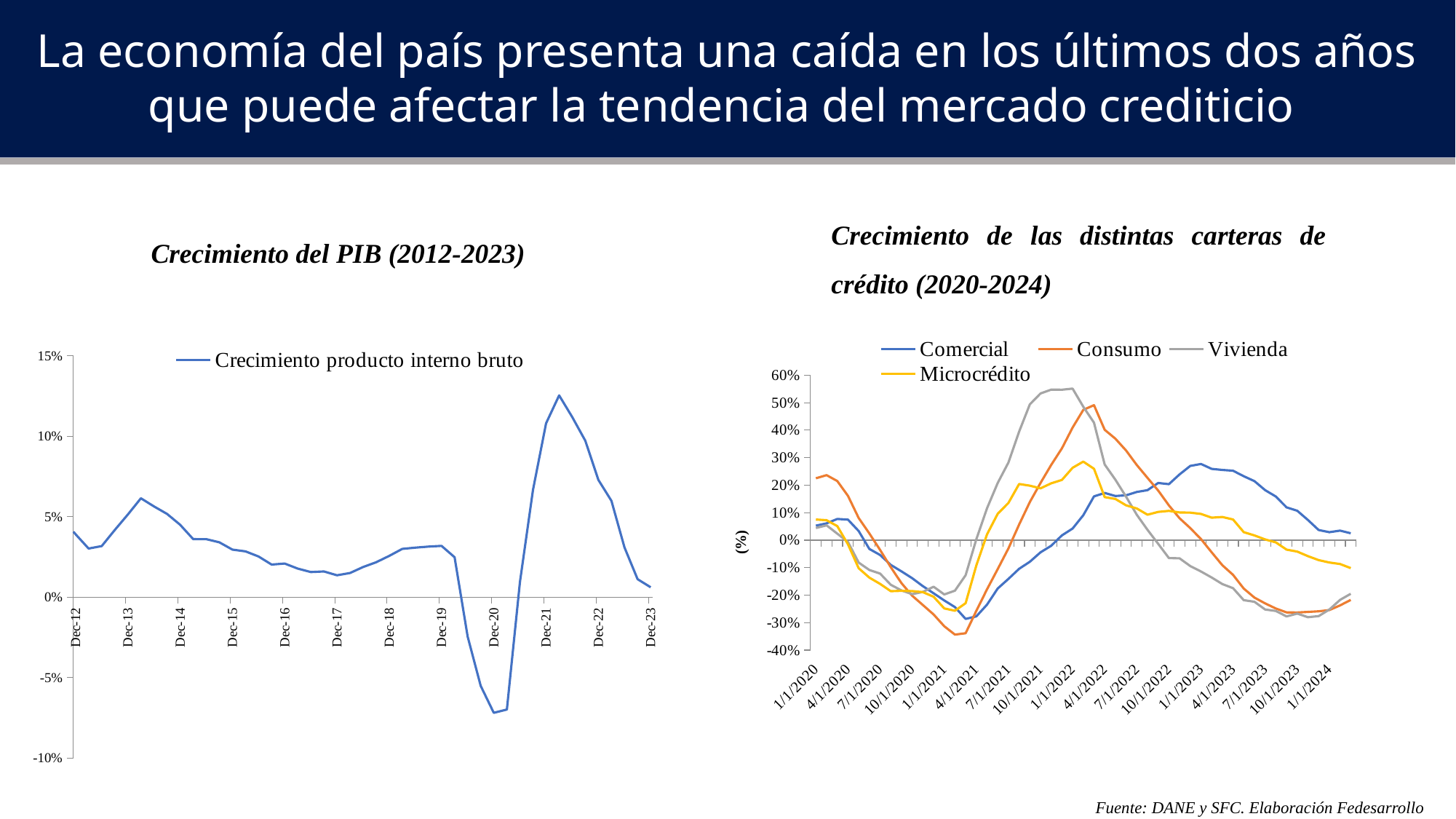
In the 'Crecimiento del PIB (2012-2023)' chart, is the value at Dec-20 greater or less than -5%? less In the 'Crecimiento de las distintas carteras de crédito (2020-2024)' chart, is the Vivienda value at 1/1/2022 greater or less than 50%? greater What kind of chart is the 'Crecimiento del PIB (2012-2023)' chart? line chart In the 'Crecimiento del PIB (2012-2023)' chart, what is the name of the series shown in the legend? Crecimiento producto interno bruto In the 'Crecimiento del PIB (2012-2023)' chart, is the value at Dec-21 greater or less than 10%? greater In the 'Crecimiento de las distintas carteras de crédito (2020-2024)' chart, which series reaches the highest peak? Vivienda In the 'Crecimiento del PIB (2012-2023)' chart, does the value rise or fall from Dec-21 to Dec-23? fall In the 'Crecimiento de las distintas carteras de crédito (2020-2024)' chart, which series reaches the lowest value? Consumo In the 'Crecimiento de las distintas carteras de crédito (2020-2024)' chart, which is larger at 1/1/2023: Comercial or Consumo? Comercial How many series does the legend of the 'Crecimiento de las distintas carteras de crédito (2020-2024)' chart list? 4